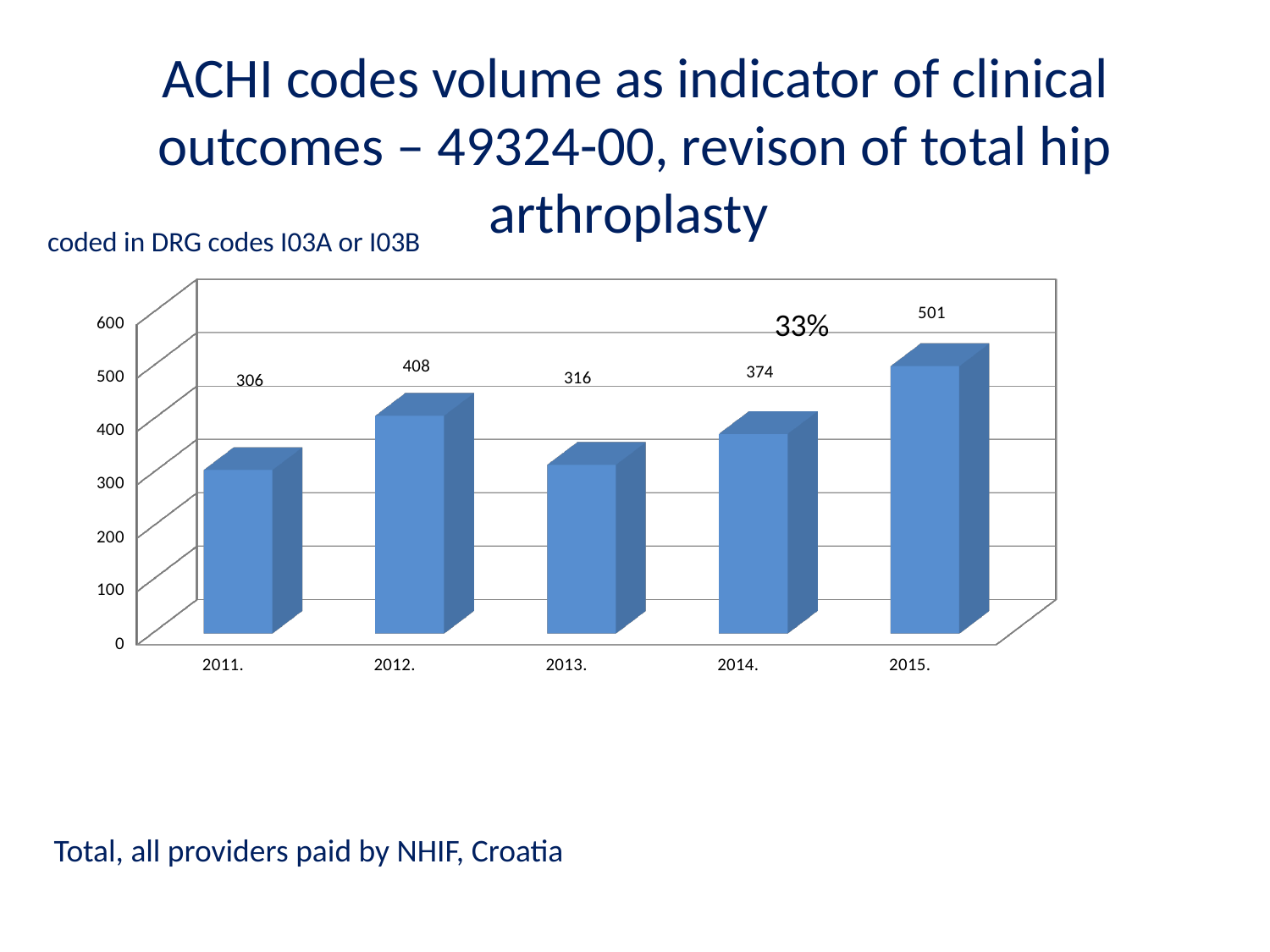
What is the value for 2011.? 306 What is the value for 2013.? 316 What is the difference between the values for 2012. and 2013.? 92 Which is larger, the value for 2012. or the value for 2014.? 2012. What percentage annotation is printed above the 2014. bar? 33% What kind of chart is shown on the slide? bar chart Which year has the highest value? 2015. What is the difference between the values for 2015. and 2014.? 127 Is the value for 2014. greater or less than 300? greater How many years are shown on the x axis? 5 What is the value for 2015.? 501 Which year has the lowest value? 2011.